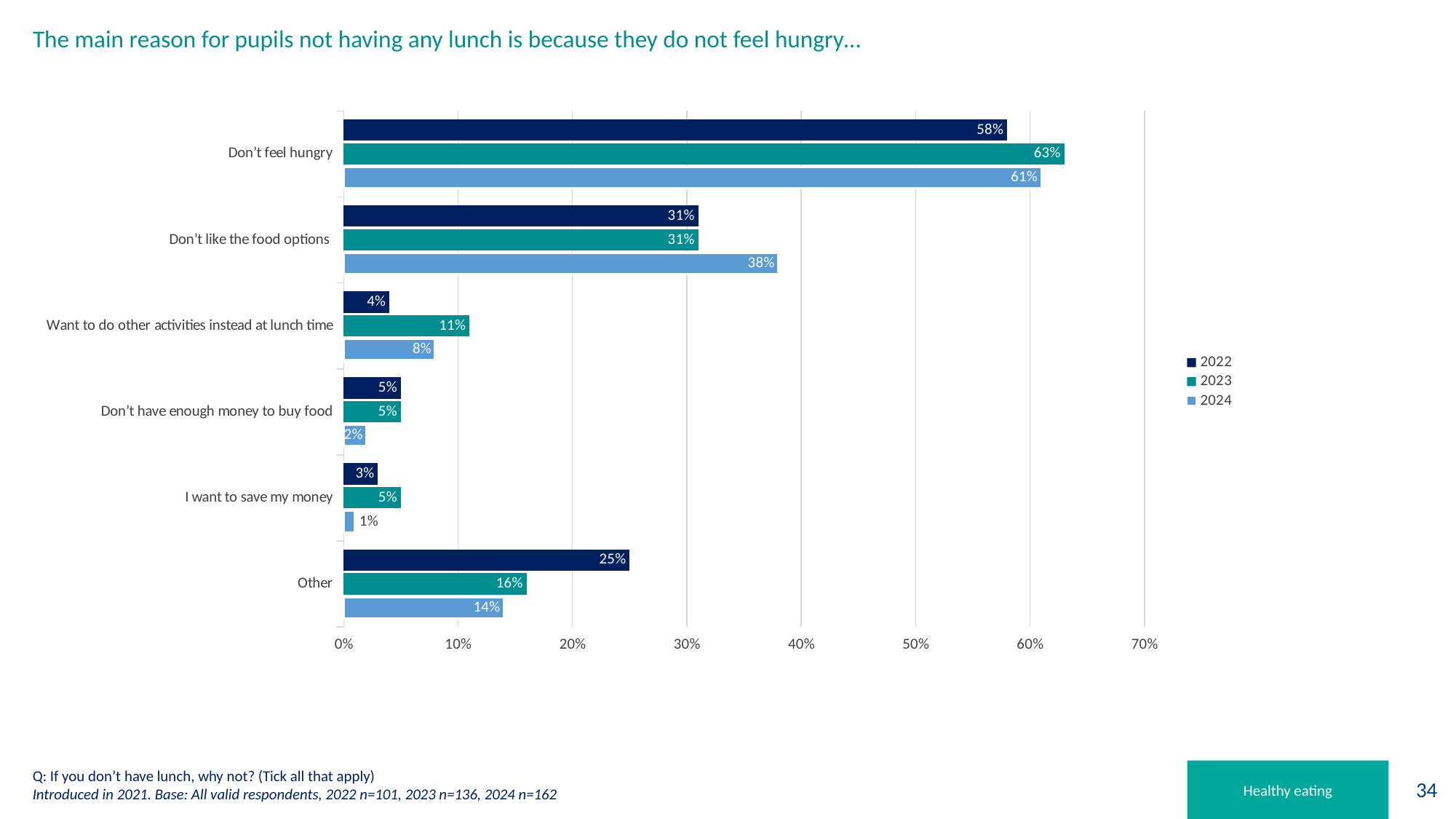
Which years are listed in the chart legend? 2022, 2023, 2024 How many reason categories are shown on the chart? 6 What is the difference between the 2023 and 2022 values for 'Don't feel hungry'? 5 percentage points Which is larger for 'Want to do other activities instead at lunch time': the 2023 value or the 2024 value? 2023 Is the 2024 value for 'Don't feel hungry' greater or less than 50%? greater What is the 2022 value for 'Other'? 25% How many series does the legend list? 3 What percentage of pupils in 2023 said they don't feel hungry? 63% What is the 2024 value for 'Don't like the food options'? 38% Which reason has the highest value in 2024? Don't feel hungry Which reason has the lowest value in 2024? I want to save my money What type of chart is shown on the slide? Bar chart